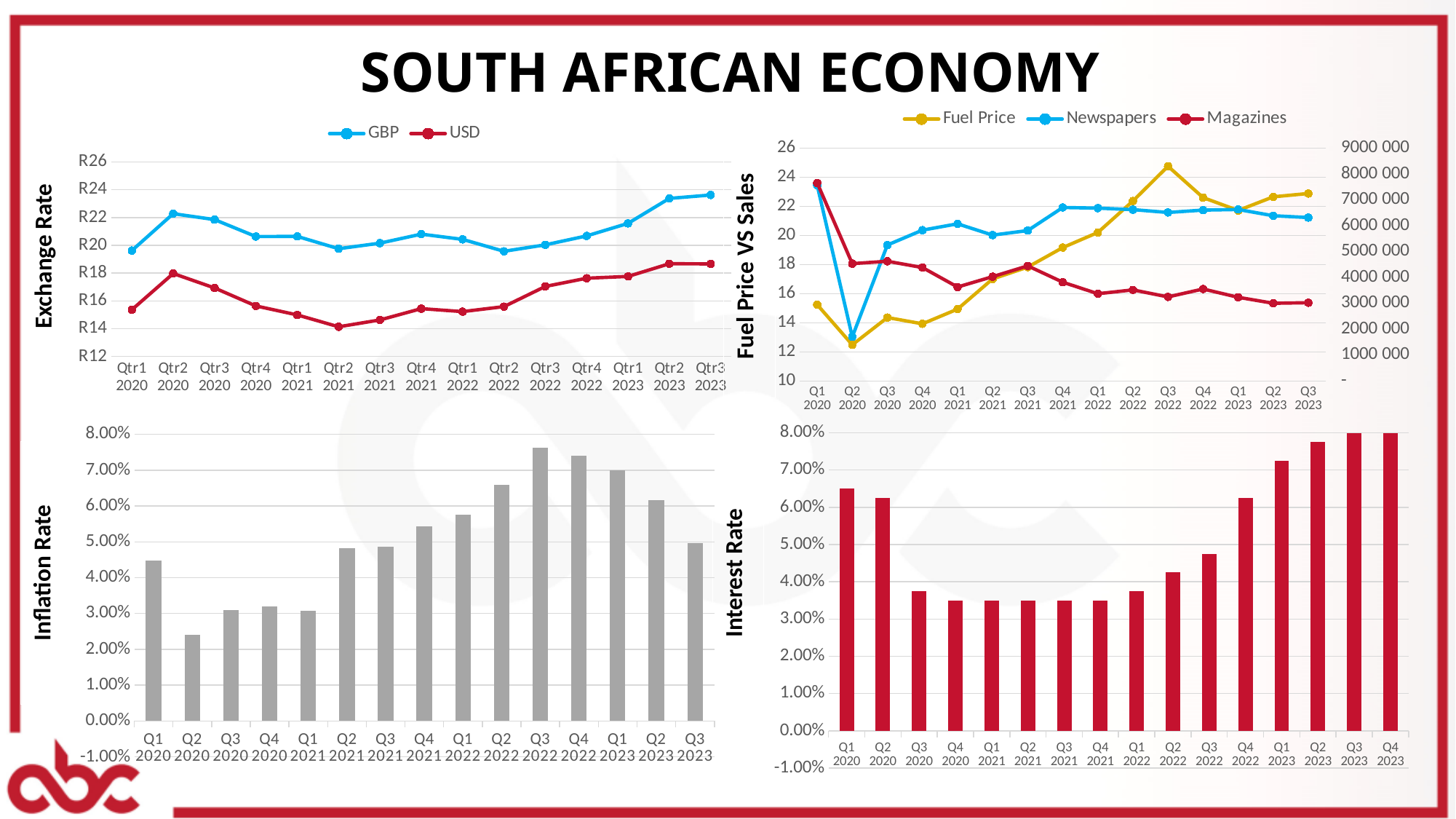
On the Interest Rate chart, how many quarters are plotted? 16 On the Exchange Rate chart, is the GBP value for Qtr3 2023 greater or less than R22? greater On the Exchange Rate chart, is the USD value for Qtr1 2020 greater or less than R16? less On the Exchange Rate chart, in which quarter is the USD series at its lowest? Qtr2 2021 What kind of chart is the Inflation Rate chart? bar chart On the Inflation Rate chart, which quarter has the lowest inflation rate? Q2 2020 On the Fuel Price VS Sales chart, in which quarter is the Magazines series at its highest? Q1 2020 On the Inflation Rate chart, is the value for Q1 2020 greater or less than 4.00%? greater On the Fuel Price VS Sales chart, in which quarter does the Fuel Price series reach its highest point? Q3 2022 On the Fuel Price VS Sales chart, in which quarter is the Newspapers series at its lowest? Q2 2020 On the Fuel Price VS Sales chart, how many series does the legend list? 3 On the Exchange Rate chart, how many series does the legend list? 2